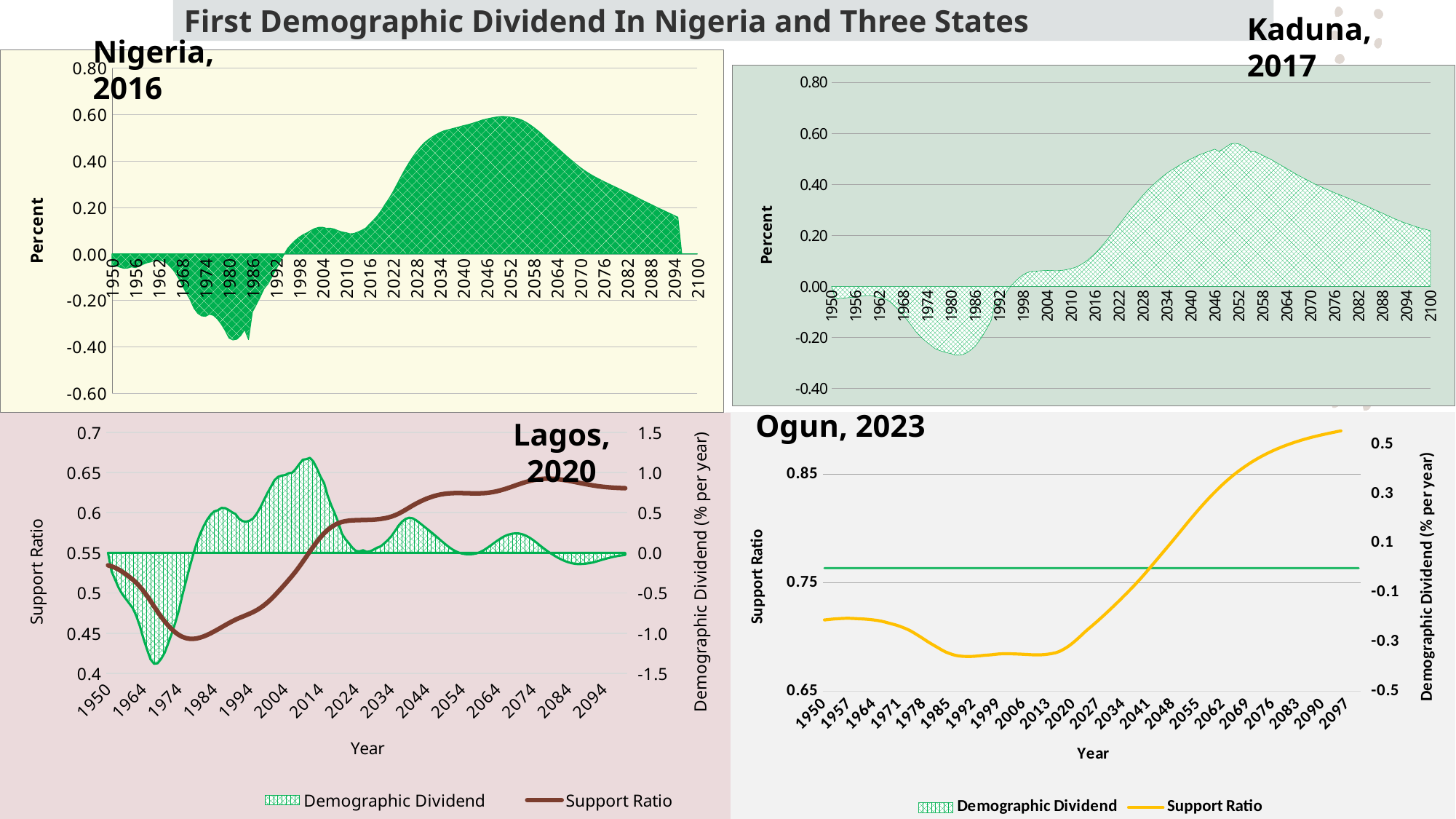
In the Nigeria, 2016 chart, what is the label of the vertical axis? Percent In the Lagos, 2020 chart, is the Support Ratio for 1950 greater or less than 0.55? less In the Nigeria, 2016 chart, what kind of chart is shown? area chart In the Ogun, 2023 chart, does the Support Ratio rise or fall between 2020 and 2097? rise In the Ogun, 2023 chart, is the Support Ratio for 1950 greater or less than 0.75? less In the Kaduna, 2017 chart, is the value for 2052 greater or less than 0.40? greater In the Lagos, 2020 chart, how many series does the legend list? 2